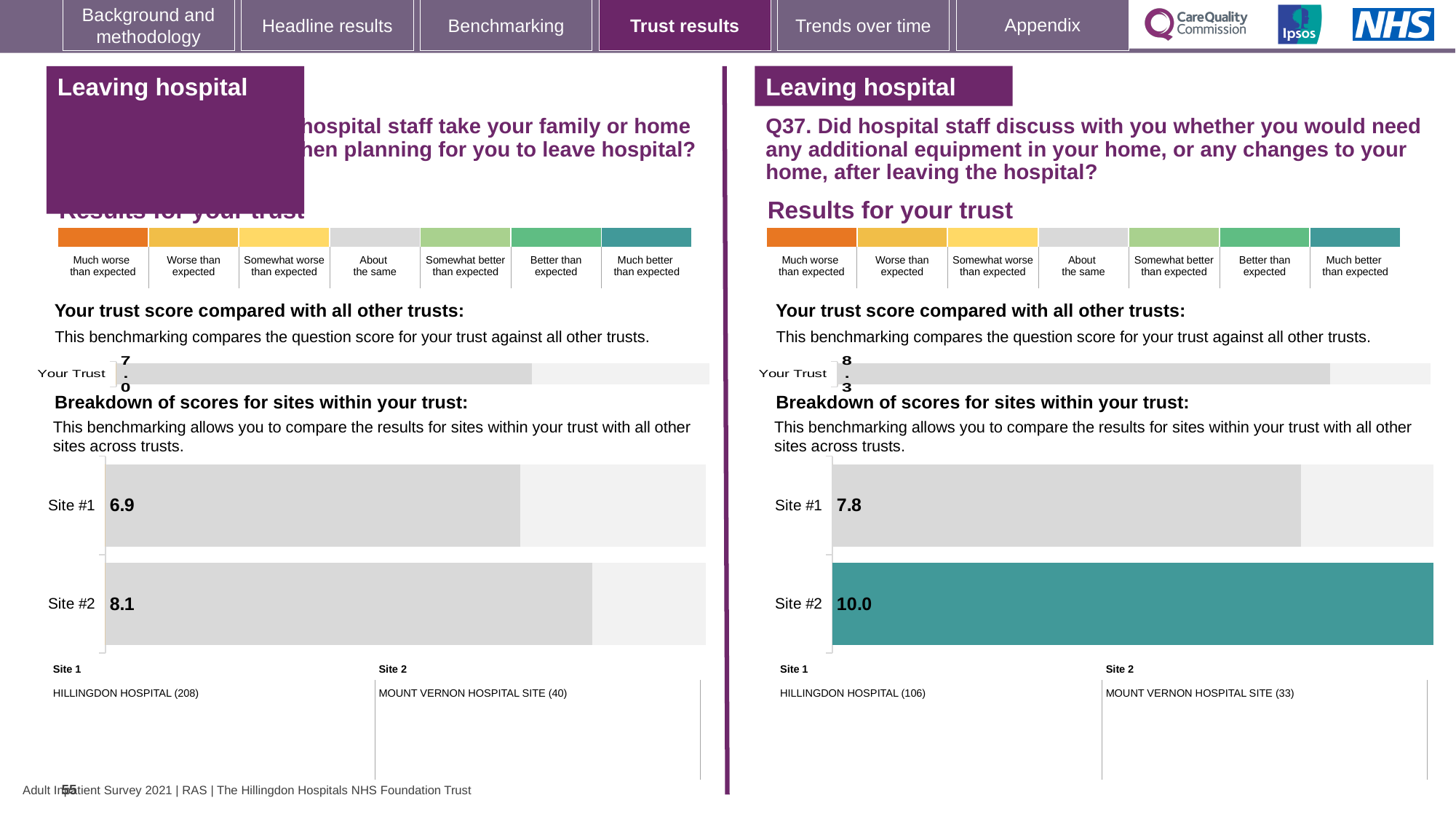
On the left-hand 'Your trust score compared with all other trusts' chart, what is the score shown for Your Trust? 7.0 On the left-hand site breakdown chart, what is the difference between the Site #2 and Site #1 scores? 1.2 How many sites are shown on the right-hand (Q37) site breakdown chart? 2 On the right-hand (Q37) 'Your trust score compared with all other trusts' chart, what is the score shown for Your Trust? 8.3 On the right-hand (Q37) site breakdown chart, what is the difference between the Site #2 and Site #1 scores? 2.2 On the right-hand (Q37) site breakdown chart, what is the score for Site #2? 10.0 On the right-hand (Q37) site breakdown chart, which site has the higher score? Site #2 What kind of chart is the left-hand site breakdown chart? Bar chart On the right-hand (Q37) site breakdown chart, what is the score for Site #1? 7.8 On the left-hand site breakdown chart, what is the score for Site #1? 6.9 On the left-hand site breakdown chart, which site has the lower score? Site #1 On the left-hand site breakdown chart, what is the score for Site #2? 8.1